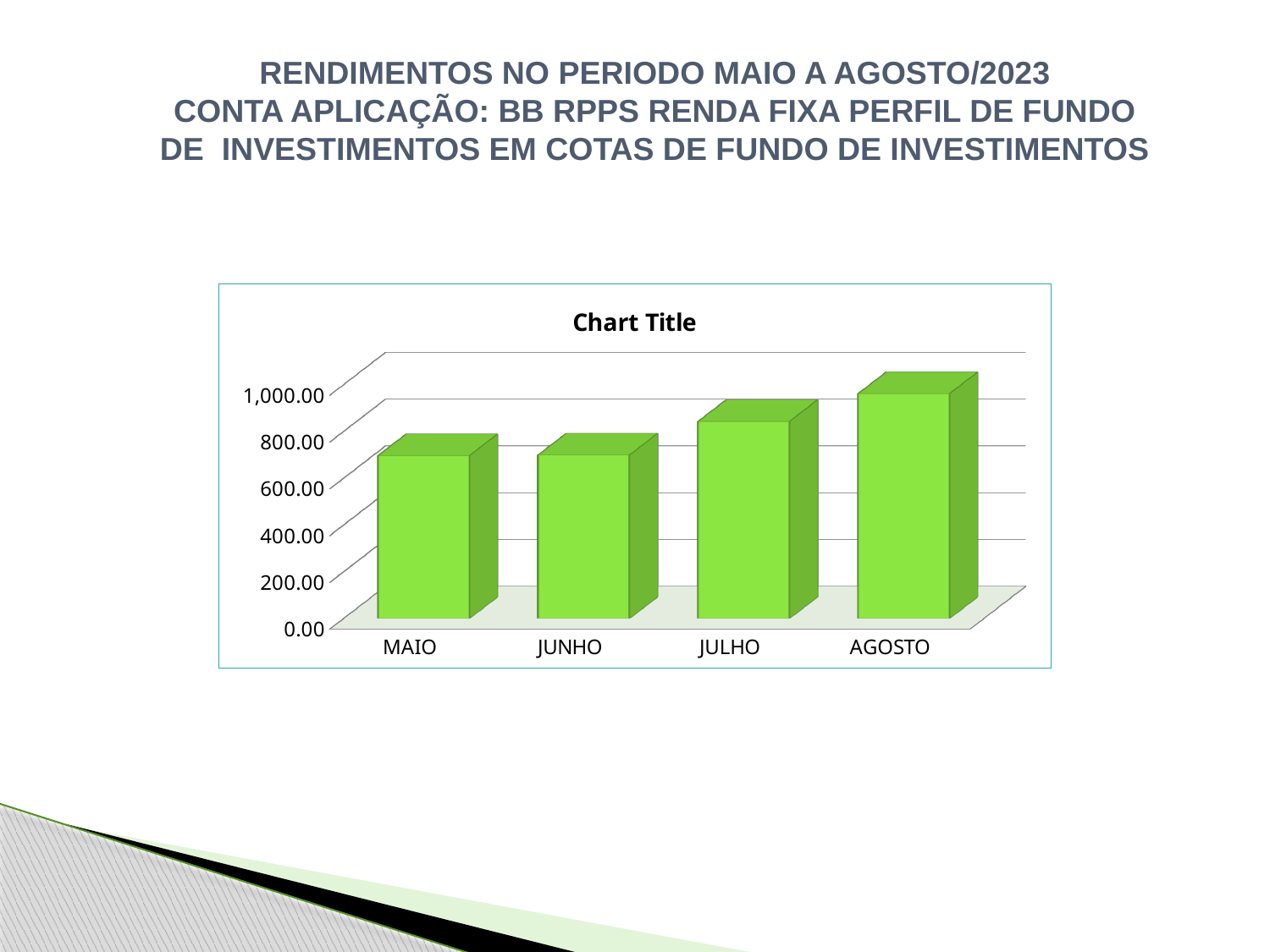
Is the value for AGOSTO greater or less than 800? greater Which is larger, the value for AGOSTO or the value for JUNHO? AGOSTO Is the value for JULHO greater or less than 600? greater Do the values generally rise or fall from MAIO to AGOSTO? rise What colour are the bars in the chart? green Is the value for MAIO greater or less than 1,000? less Which is larger, the value for JULHO or the value for MAIO? JULHO What title is printed above the chart's plot area? Chart Title How many categories are shown on the x axis of the chart? 4 Which month has the highest bar in the chart? AGOSTO What kind of chart is shown on the slide? bar chart